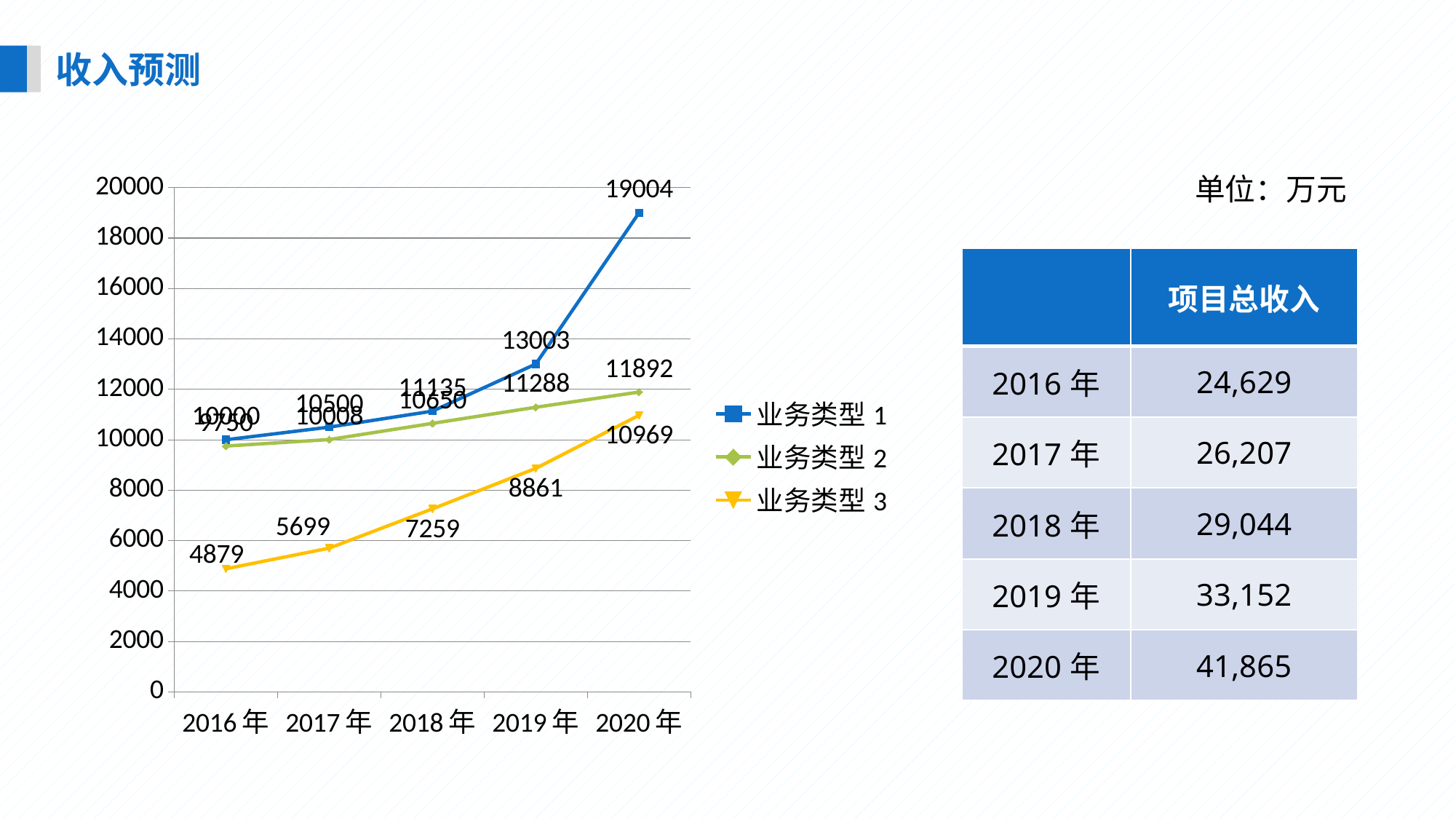
What is the value for 业务类型 1 in 2020 年? 19004 How many years are shown on the x axis of the chart? 5 How many series does the chart legend list? 3 What kind of chart is shown on the slide? line chart What is the value for 业务类型 2 in 2019 年? 11288 Which series has the lowest value in 2018 年? 业务类型 3 What is the value for 业务类型 3 in 2016 年? 4879 In 2020 年, which is larger: 业务类型 2 or 业务类型 3? 业务类型 2 What is the difference between the 业务类型 2 values for 2020 年 and 2018 年? 1242 In which year does 业务类型 1 reach its highest value? 2020 年 What is the difference between the 业务类型 1 values for 2020 年 and 2019 年? 6001 Is the value for 业务类型 3 in 2019 年 greater or less than 8000? greater